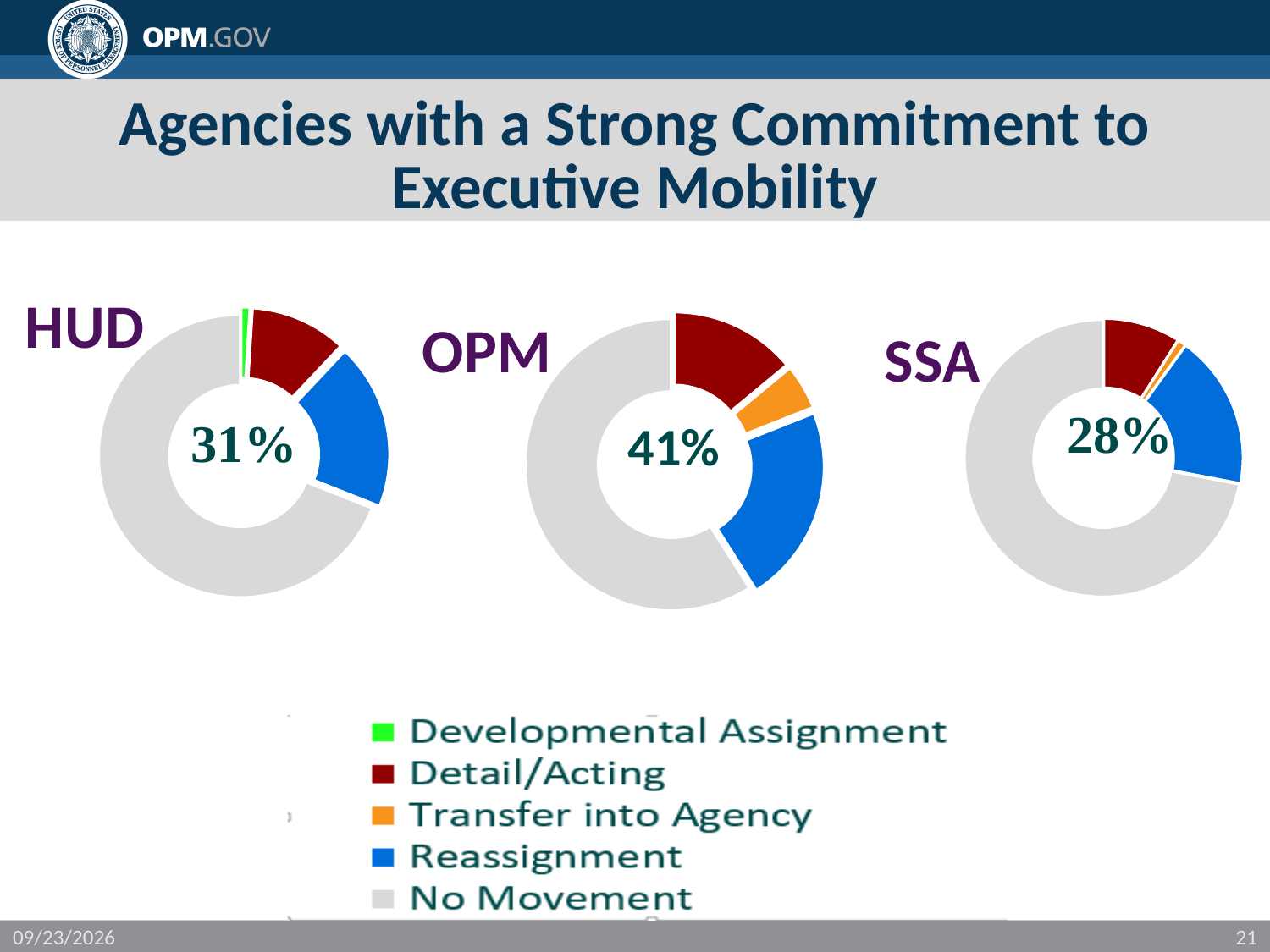
What is the difference between the percentage shown for OPM and the percentage shown for HUD? 10 percentage points How many agency charts are shown on the slide? 3 Which is larger, the percentage shown for HUD or the percentage shown for SSA? HUD What percentage is shown in the centre of the OPM chart? 41% What percentage is shown in the centre of the HUD chart? 31% What percentage is shown in the centre of the SSA chart? 28% Which agency's chart shows the lowest percentage in its centre? SSA What kind of chart is used to show the HUD data? donut chart In the HUD chart, which category occupies the smallest share of the ring? Developmental Assignment Which agency's chart shows the highest percentage in its centre? OPM In the SSA chart, which category occupies the largest share of the ring? No Movement How many categories does the legend list? 5